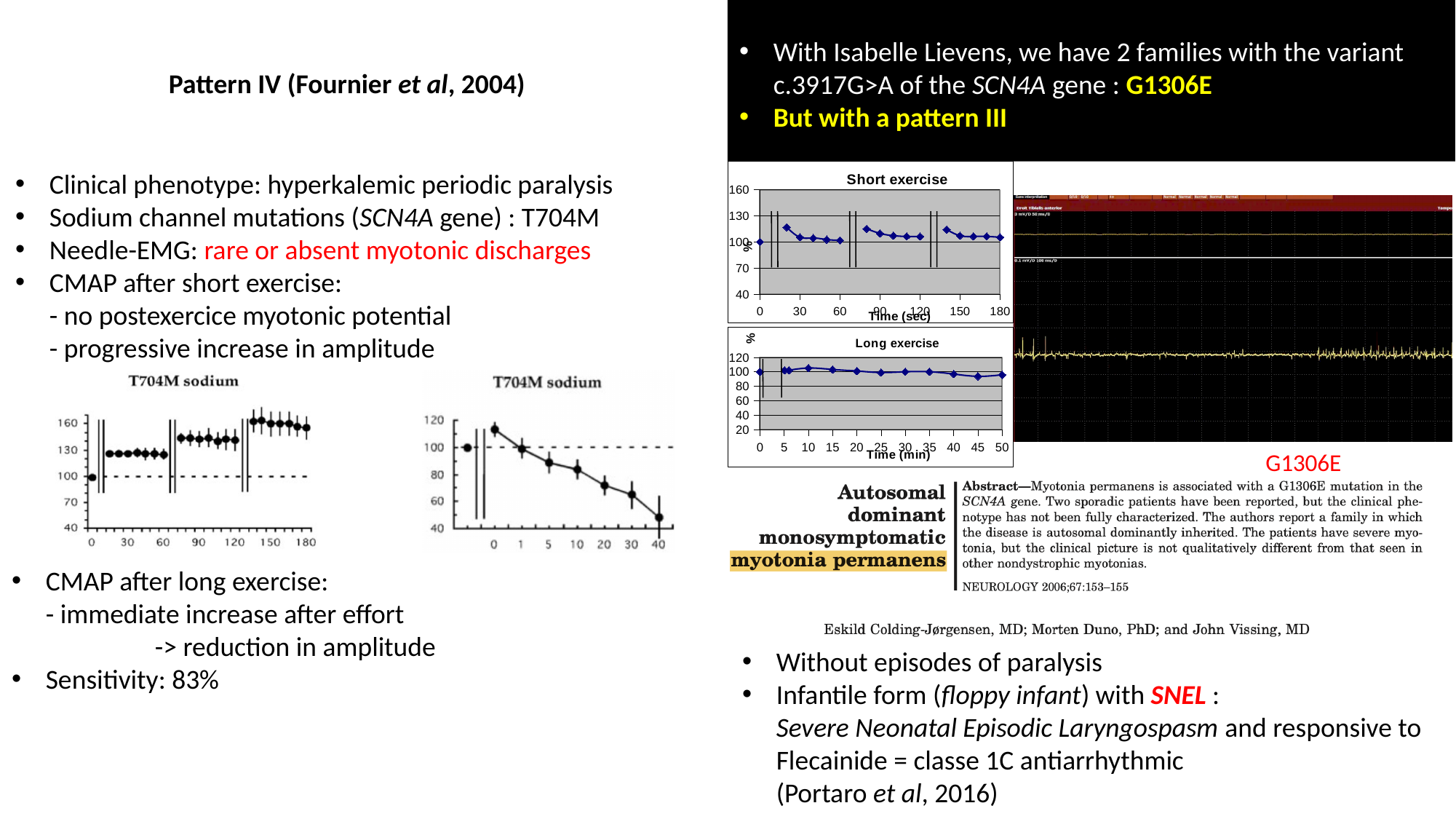
In the right-hand 'T704M sodium' chart (x axis 0 to 40), is the value at 40 greater or less than 60? less In the right-hand 'T704M sodium' chart (x axis 0 to 40), do the values rise or fall along the x axis? fall What kind of chart is the 'Short exercise' chart on the right of the slide? line chart In the 'Long exercise' chart, do the values rise or fall between 10 and 45 minutes? fall In the 'Long exercise' chart, what is the title of the x axis? Time (min) In the 'Long exercise' chart, is the value at 45 minutes greater or less than 80? greater In the left-hand 'T704M sodium' chart (x axis 0 to 180), do the values rise or fall from the first block of points to the last block? rise In the 'Short exercise' chart, is the value at 0 seconds greater or less than 70? greater In the 'Short exercise' chart, what is the title of the x axis? Time (sec) In the 'Long exercise' chart, which is larger, the value at 10 minutes or the value at 45 minutes? 10 minutes